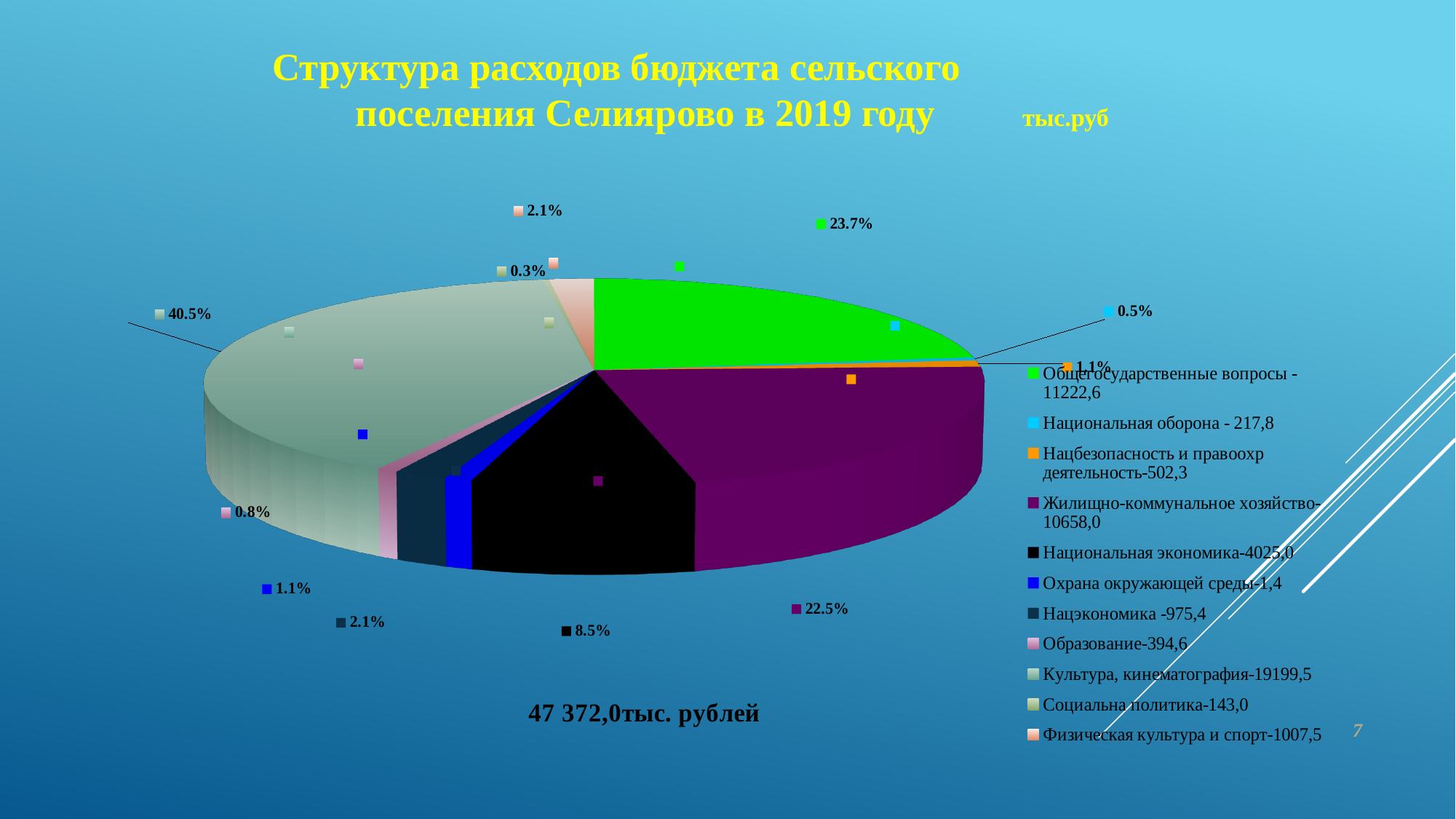
Which category has the smallest share of the pie? Социальна политика Which category has the largest share of the pie? Культура, кинематография How many categories does the legend of the pie chart list? 11 What is the difference in percentage points between the shares of Общегосударственные вопросы (23.7%) and Жилищно-коммунальное хозяйство (22.5%)? 1.2 What share of the pie does Национальная экономика have? 8.5% What total amount is printed below the pie chart? 47 372,0тыс. рублей What kind of chart is shown on the slide? pie chart What share of the pie does Жилищно-коммунальное хозяйство have? 22.5% Which has the larger share: Общегосударственные вопросы or Жилищно-коммунальное хозяйство? Общегосударственные вопросы What value does the legend give for Национальная оборона? 217,8 What share of the pie does Общегосударственные вопросы have? 23.7% What value does the legend give for Жилищно-коммунальное хозяйство? 10658,0